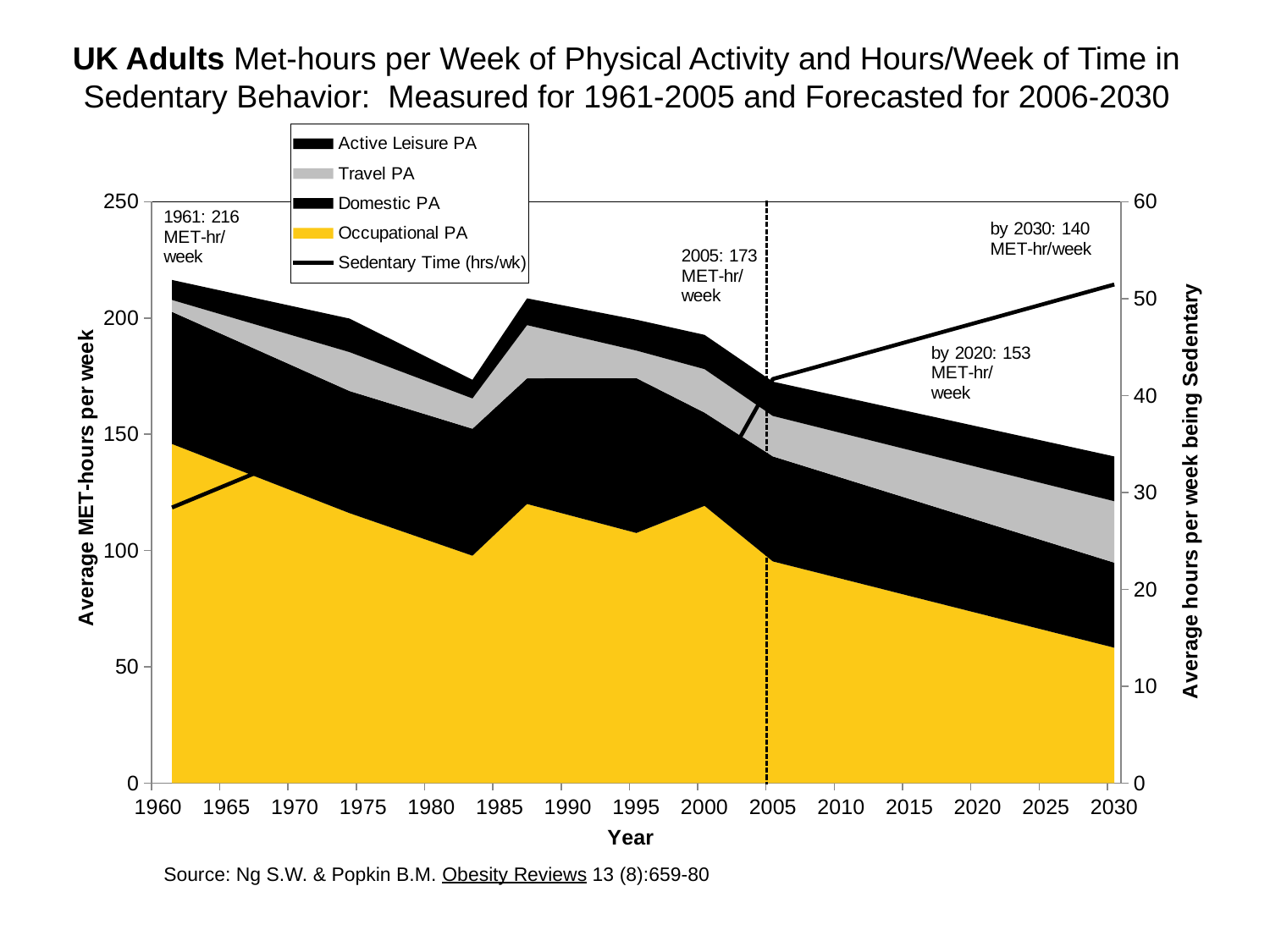
What kind of chart is this? Stacked area chart with a line Which year has the higher labelled total MET-hours per week, 1961 or 2030? 1961 What is the labelled total MET-hours per week in 2005? 173 MET-hr/week Which series is shown in yellow? Occupational PA Is the Occupational PA value in 1961 greater or less than 100 MET-hours per week? greater What is the total MET-hours per week of physical activity for UK adults in 1961, as labelled on the chart? 216 MET-hr/week Does the total MET-hours per week of physical activity rise or fall from 1961 to 2030? Fall What total MET-hours per week is forecast for 2020? 153 MET-hr/week How many series does the legend list? 5 What is the difference between the 1961 total (216) and the 2005 total (173) in MET-hours per week? 43 By how many MET-hours per week is the 2030 forecast total lower than the 1961 total? 76 What total MET-hours per week is forecast for 2030? 140 MET-hr/week